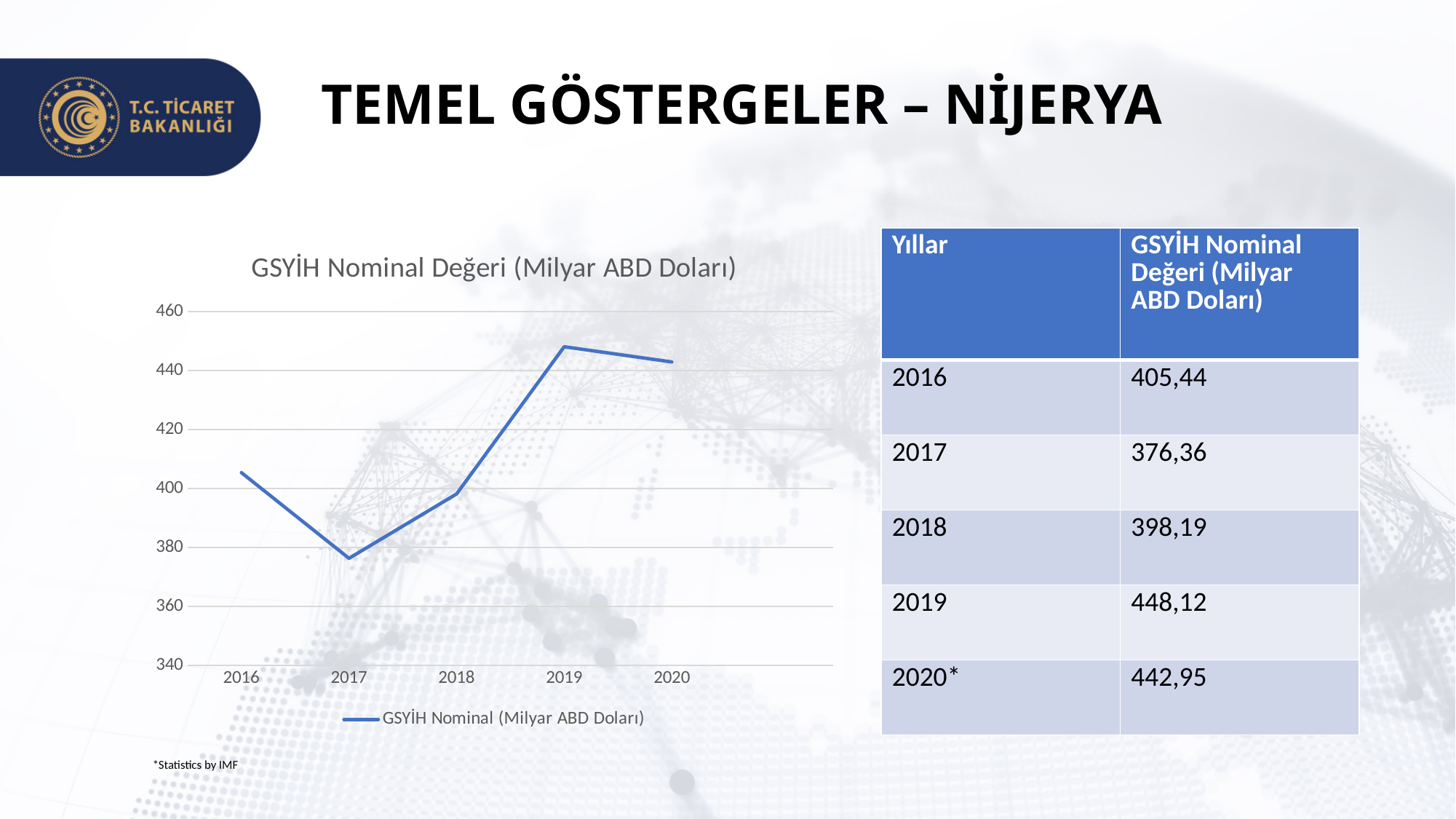
Which is larger, the GSYİH Nominal value for 2016 or for 2017? 2016 What type of chart is shown on the slide? line chart How many series does the chart legend list? 1 Is the GSYİH Nominal value for 2017 greater or less than 380? less Is the GSYİH Nominal value for 2019 greater or less than 440? greater According to the slide, what is the GSYİH Nominal value for 2019 in billion US dollars? 448,12 Does the GSYİH Nominal value rise or fall from 2017 to 2019? rise What is the title of the chart? GSYİH Nominal Değeri (Milyar ABD Doları) Which year has the highest GSYİH Nominal value? 2019 How many years are plotted on the x axis of the chart? 5 Which year has the lowest GSYİH Nominal value? 2017